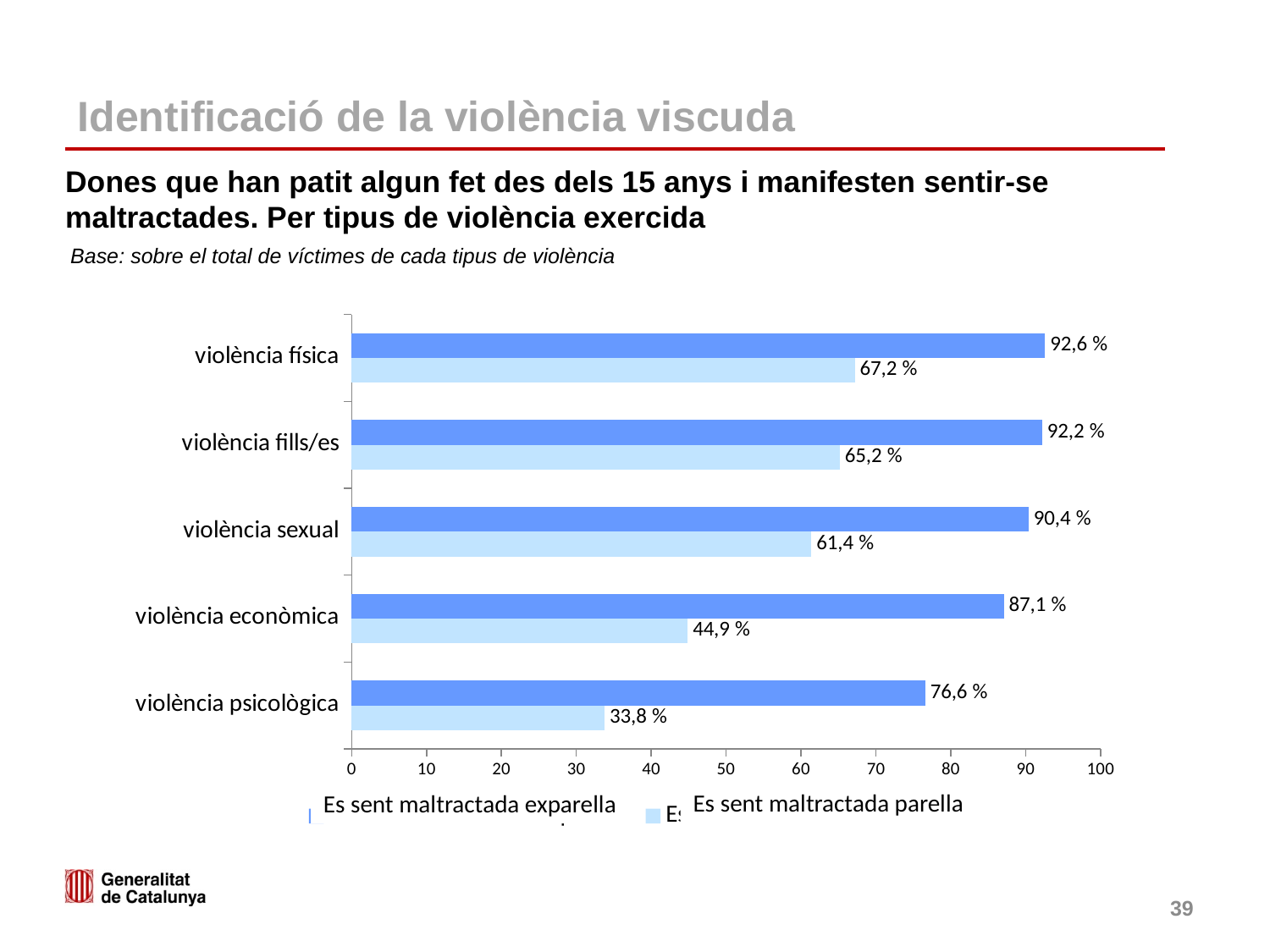
Is the 'Es sent maltractada parella' value for violència econòmica greater or less than 50? less What kind of chart is shown on the slide? bar chart What is the value for violència econòmica in the 'Es sent maltractada parella' series? 44,9 % How many categories of violence are shown on the chart? 5 Which category has the lowest value in the 'Es sent maltractada parella' series? violència psicològica What is the value for violència física in the 'Es sent maltractada exparella' series? 92,6 % What is the base stated below the chart title? Base: sobre el total de víctimes de cada tipus de violència What is the difference between the 'Es sent maltractada exparella' and 'Es sent maltractada parella' values for violència psicològica? 42,8 % What is the value for violència psicològica in the 'Es sent maltractada parella' series? 33,8 % How many series does the legend list? 2 Which is larger for violència sexual: the 'Es sent maltractada exparella' value or the 'Es sent maltractada parella' value? Es sent maltractada exparella Which category has the highest value in the 'Es sent maltractada exparella' series? violència física